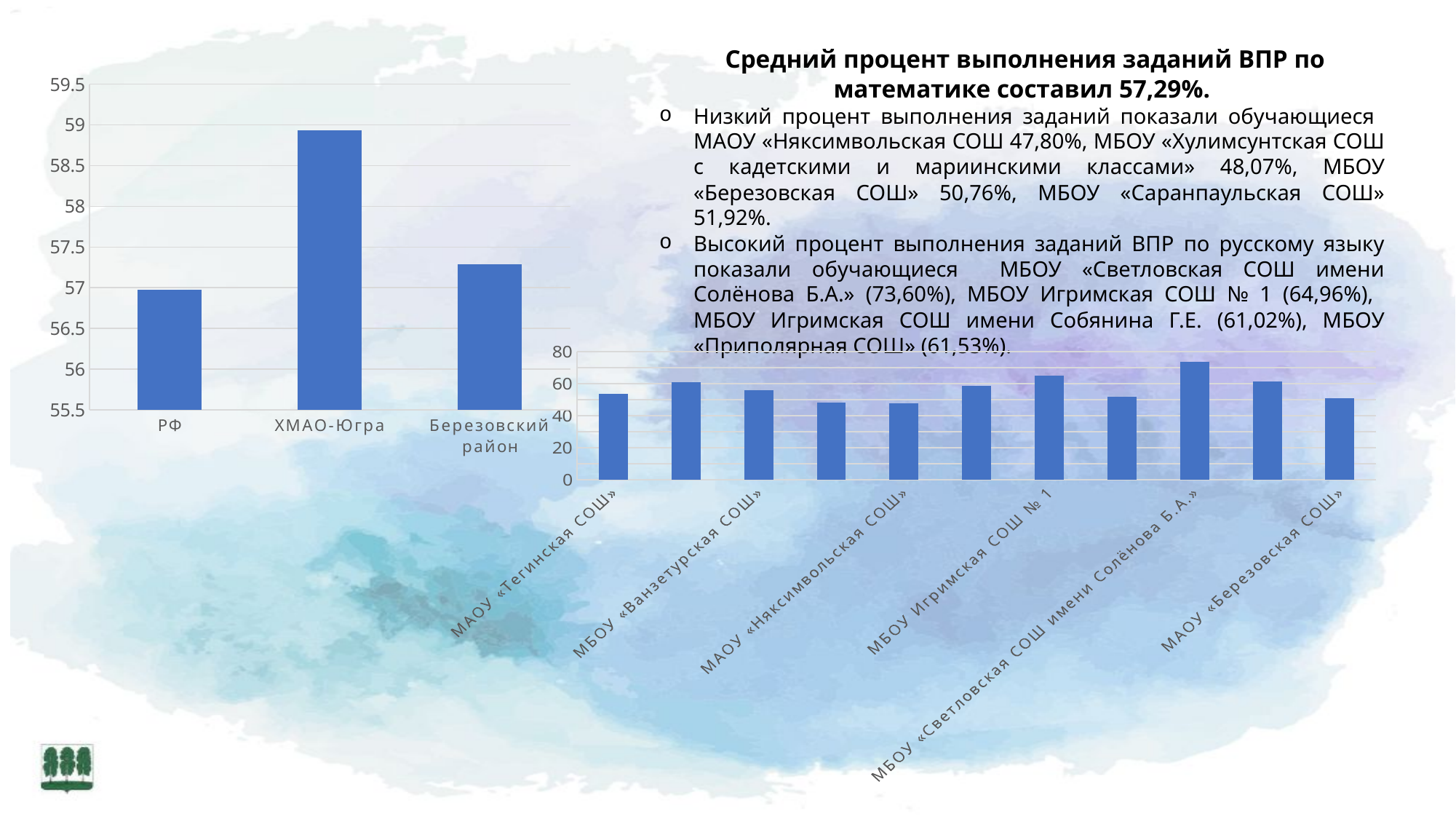
In the left chart, which category has the highest bar? ХМАО-Югра How many bars are shown in the right chart (the chart of schools)? 11 In the left chart, which category has the lowest bar? РФ In the right chart (the chart of schools), which is larger: the value for МБОУ «Ванзетурская СОШ» or МАОУ «Няксимвольская СОШ»? МБОУ «Ванзетурская СОШ» How many categories are shown in the left chart? 3 In the left chart, is the value for РФ greater or less than 57.5? less In the left chart, is the value for Березовский район greater or less than 57? greater In the left chart, is the value for ХМАО-Югра greater or less than 58.5? greater In the right chart (the chart of schools), which school has the highest bar? МБОУ «Светловская СОШ имени Солёнова Б.А.» What type of chart is the left chart? bar chart